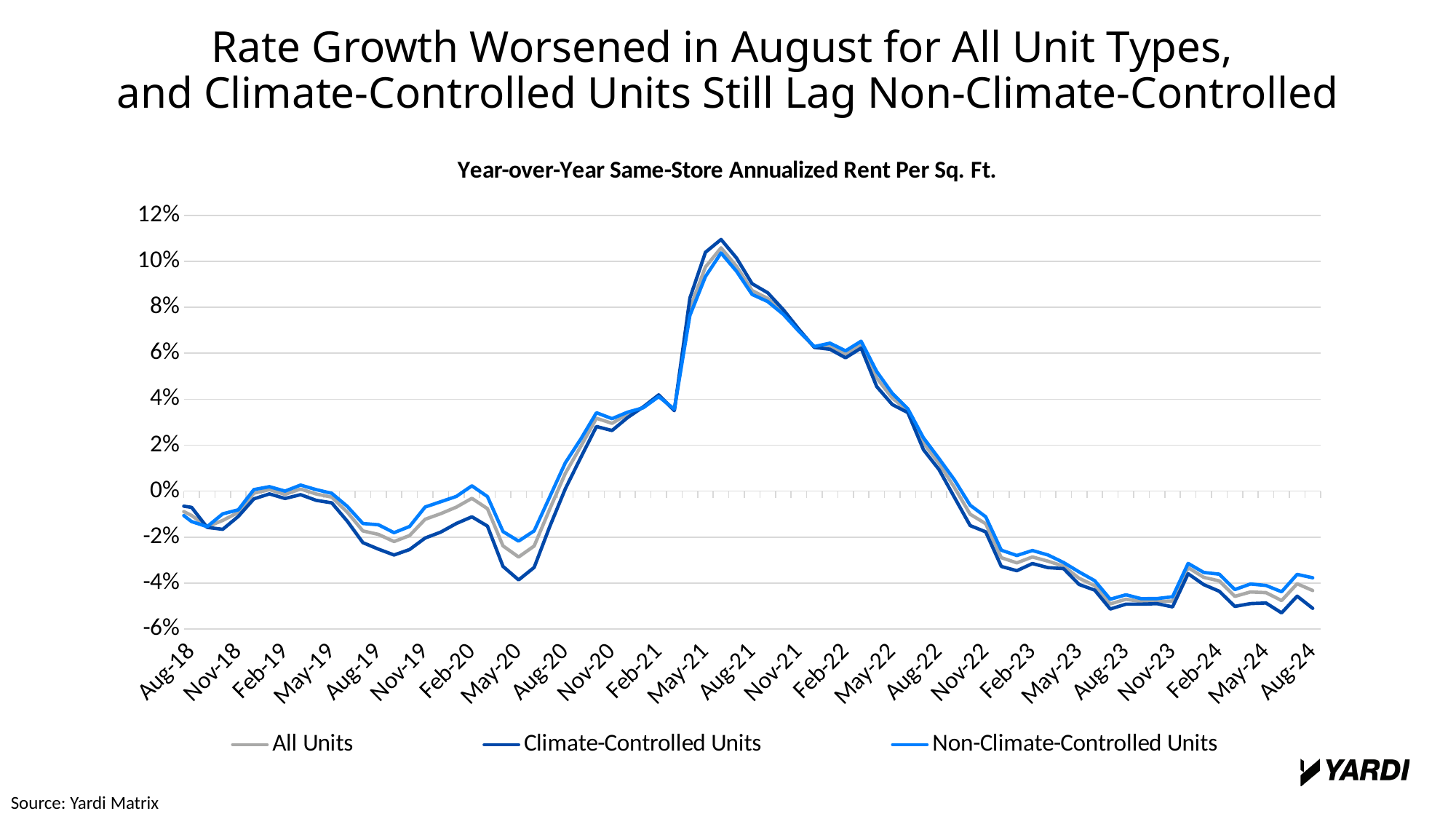
Is the value for All Units at Nov-21 greater or less than 6%? greater What is the title printed above the chart's plot area? Year-over-Year Same-Store Annualized Rent Per Sq. Ft. How many series does the legend list? 3 Is the value for Climate-Controlled Units at Aug-24 greater or less than -4%? less Is the value for Climate-Controlled Units at May-21 greater or less than 10%? greater Which series reaches the highest value at the May-21 peak? Climate-Controlled Units At Aug-24, which series has the higher value: Climate-Controlled Units or Non-Climate-Controlled Units? Non-Climate-Controlled Units What source is cited for the chart? Yardi Matrix Do the values for Non-Climate-Controlled Units rise or fall between May-20 and May-21? Rise What kind of chart is shown on the slide? Line chart Do the values for All Units rise or fall between May-21 and Aug-23? Fall